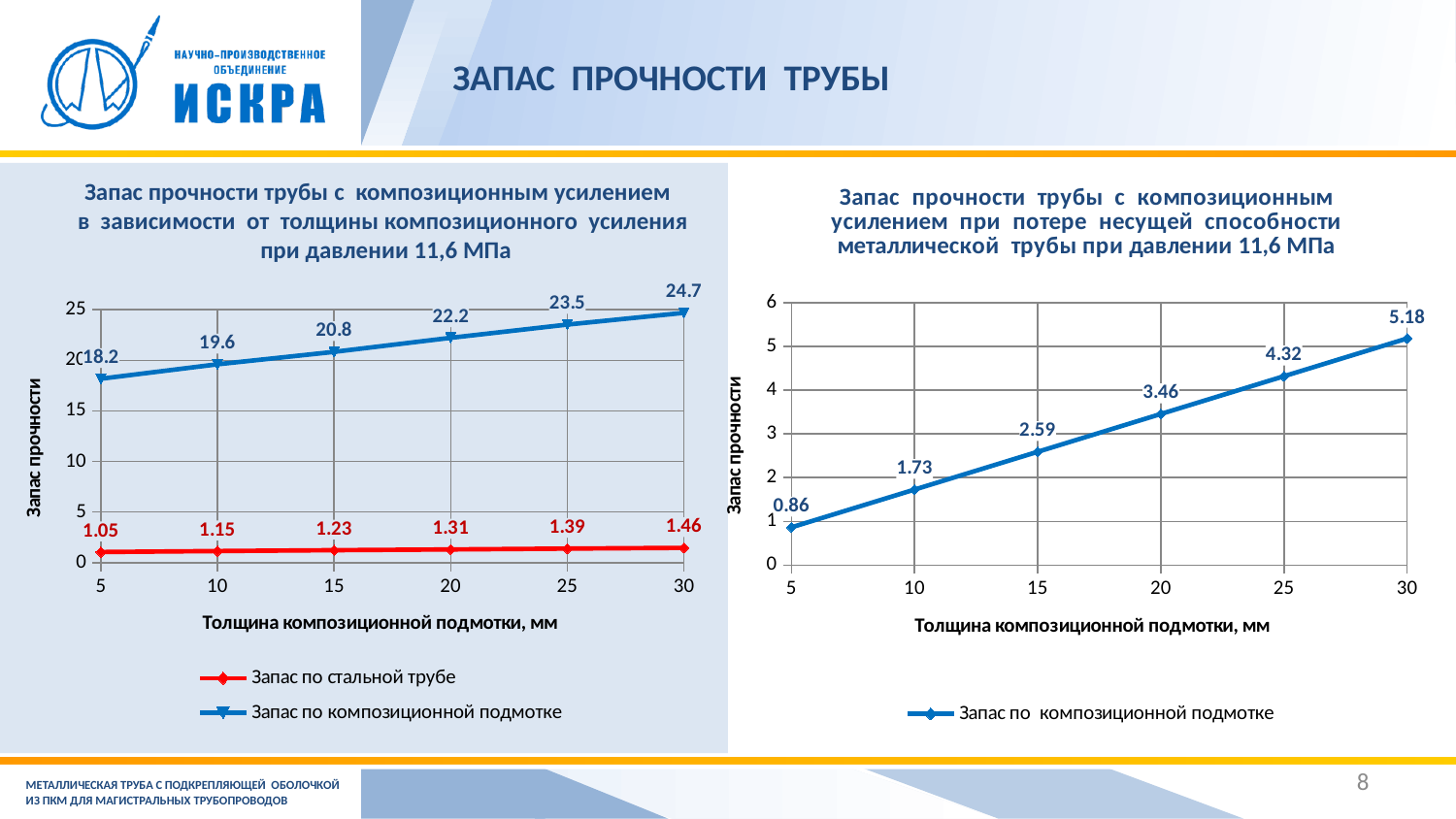
In the left chart, at which thickness is the value of 'Запас по композиционной подмотке' lowest? 5 In the left chart, what is the value of 'Запас по стальной трубе' at a thickness of 30 mm? 1.46 In the left chart, what is the difference between the 'Запас по композиционной подмотке' value at 30 mm and at 5 mm? 6.5 What type of chart is the right chart? Line chart In the right chart, what is the difference between the values at 25 mm and 10 mm? 2.59 In the left chart, what is the value of 'Запас по композиционной подмотке' at a thickness of 15 mm? 20.8 In the right chart, what is the value at a thickness of 20 mm? 3.46 How many series does the legend of the left chart list? 2 In the left chart, which series has the larger value at 20 mm: 'Запас по стальной трубе' or 'Запас по композиционной подмотке'? Запас по композиционной подмотке In the right chart, do the values rise or fall as the thickness increases from 5 to 30 mm? Rise In the right chart, at which thickness is the value highest? 30 How many data points does the line in the right chart have? 6